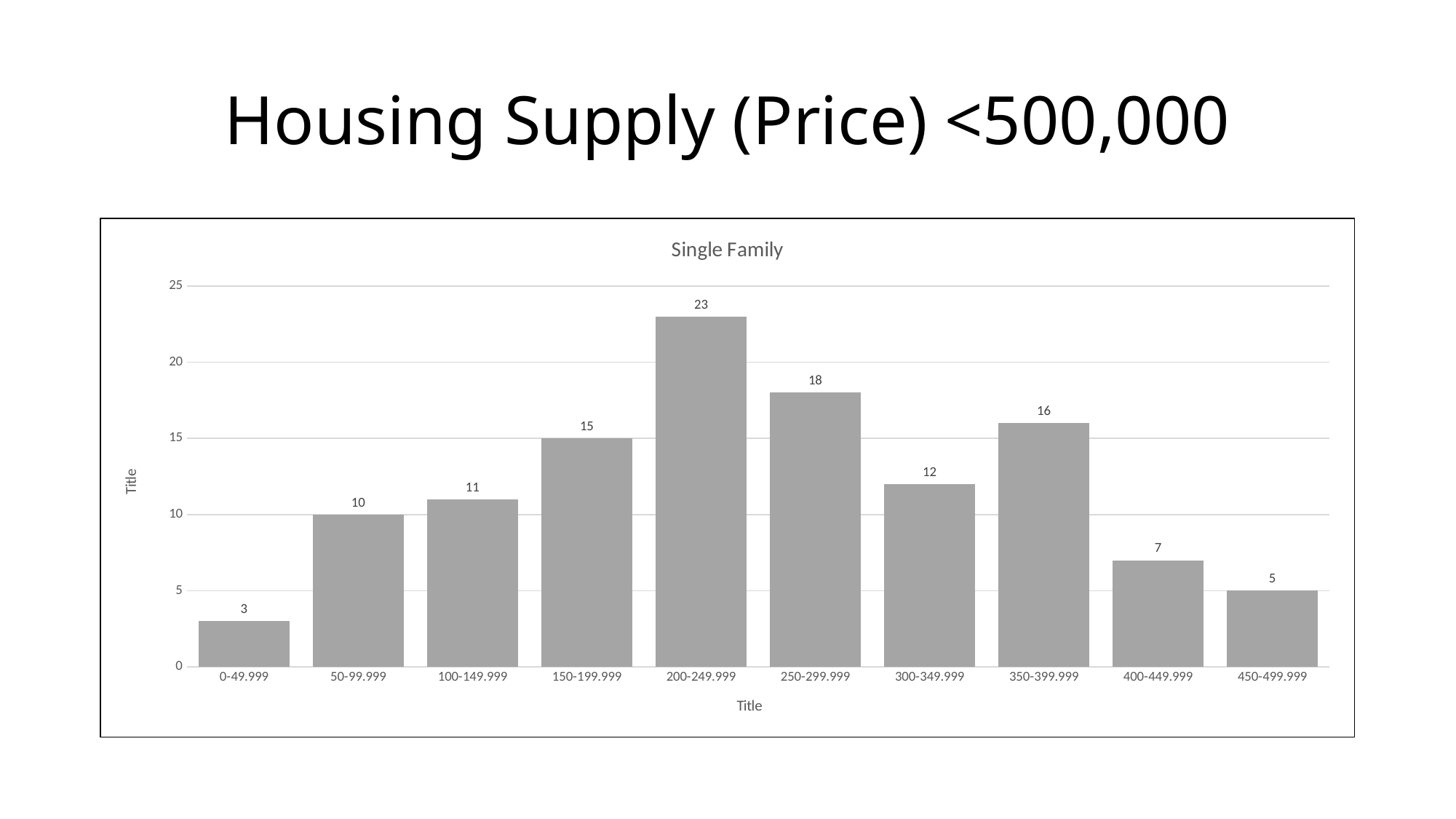
What is the difference between the values for 150-199.999 and 450-499.999? 10 What is the title of the chart? Single Family Which category has the highest value? 200-249.999 Which is larger, the value for 300-349.999 or the value for 350-399.999? 350-399.999 How many categories are shown on the x axis? 10 What is the value for the 350-399.999 category? 16 Is the value for 250-299.999 greater or less than 15? greater What kind of chart is shown on the slide? bar chart What is the value for the 200-249.999 category? 23 What is the difference between the values for 200-249.999 and 250-299.999? 5 Which category has the lowest value? 0-49.999 What is the value for the 0-49.999 category? 3